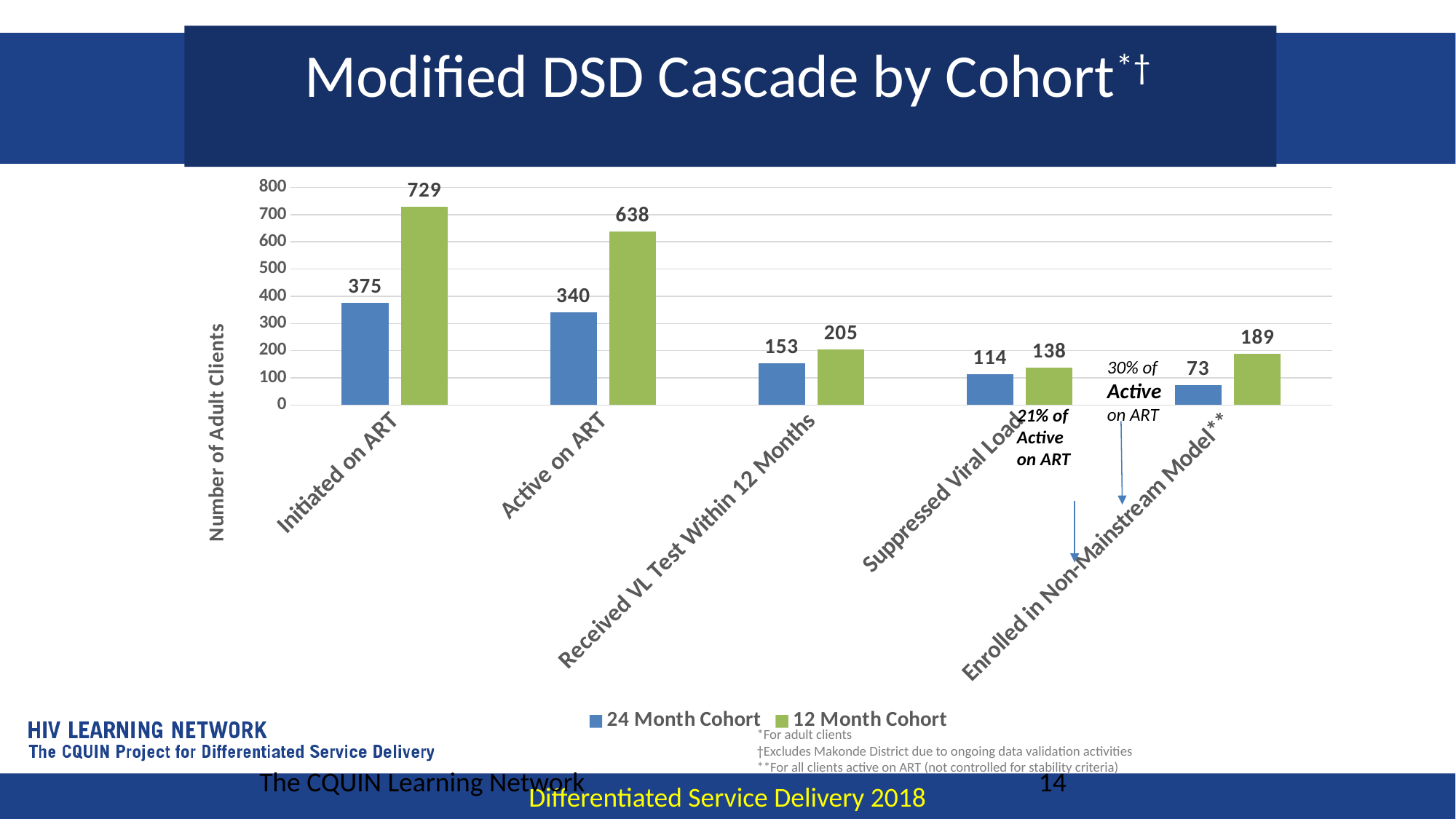
How many categories are shown on the x axis? 5 What kind of chart is shown on the slide? Bar chart Which category has the lowest value for the 24 Month Cohort? Enrolled in Non-Mainstream Model What is the difference between the 12 Month Cohort and 24 Month Cohort values for Initiated on ART? 354 What is the value for the 24 Month Cohort in the Enrolled in Non-Mainstream Model category? 73 Is the 12 Month Cohort value for Active on ART greater or less than 600? greater Which category has the highest value for the 12 Month Cohort? Initiated on ART What is the value for the 12 Month Cohort in the Initiated on ART category? 729 How many series does the legend list? 2 What is the value for the 24 Month Cohort in the Active on ART category? 340 What is the label of the y axis? Number of Adult Clients Which is larger in the Suppressed Viral Load category: the 24 Month Cohort or the 12 Month Cohort? 12 Month Cohort